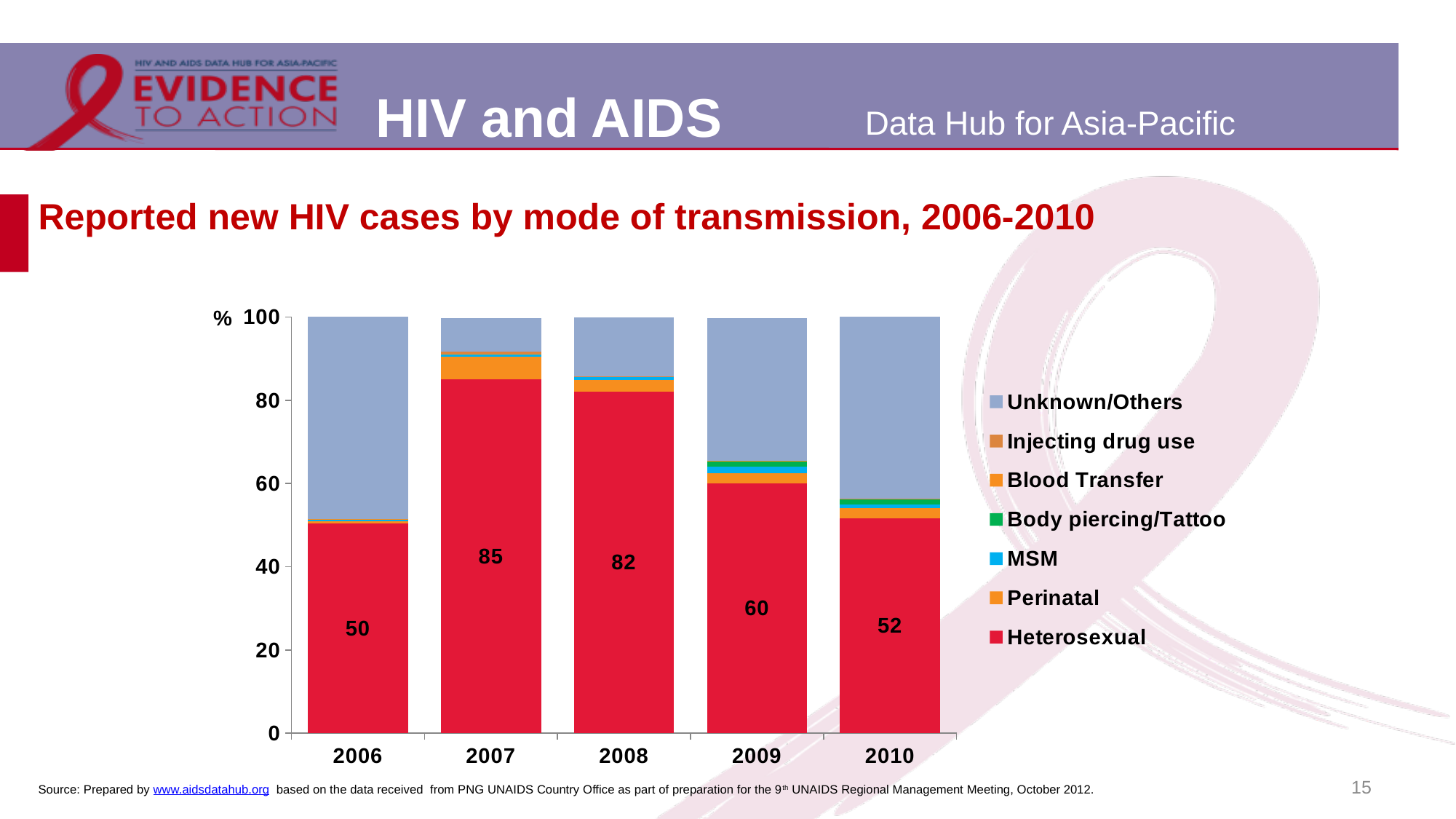
What is the Heterosexual share of reported new HIV cases in 2007? 85 Which colour represents Heterosexual in the chart? Red Is the Unknown/Others share in 2006 greater or less than 40? greater What is the Heterosexual share of reported new HIV cases in 2010? 52 What is the Heterosexual share of reported new HIV cases in 2006? 50 How many modes of transmission does the legend list? 7 Which year has a larger Heterosexual share, 2009 or 2010? 2009 What is the difference between the Heterosexual share in 2008 and in 2009? 22 How many years are shown on the x axis? 5 What kind of chart is shown on the slide? Stacked bar chart In which year is the Heterosexual share lowest? 2006 In which year is the Heterosexual share highest? 2007